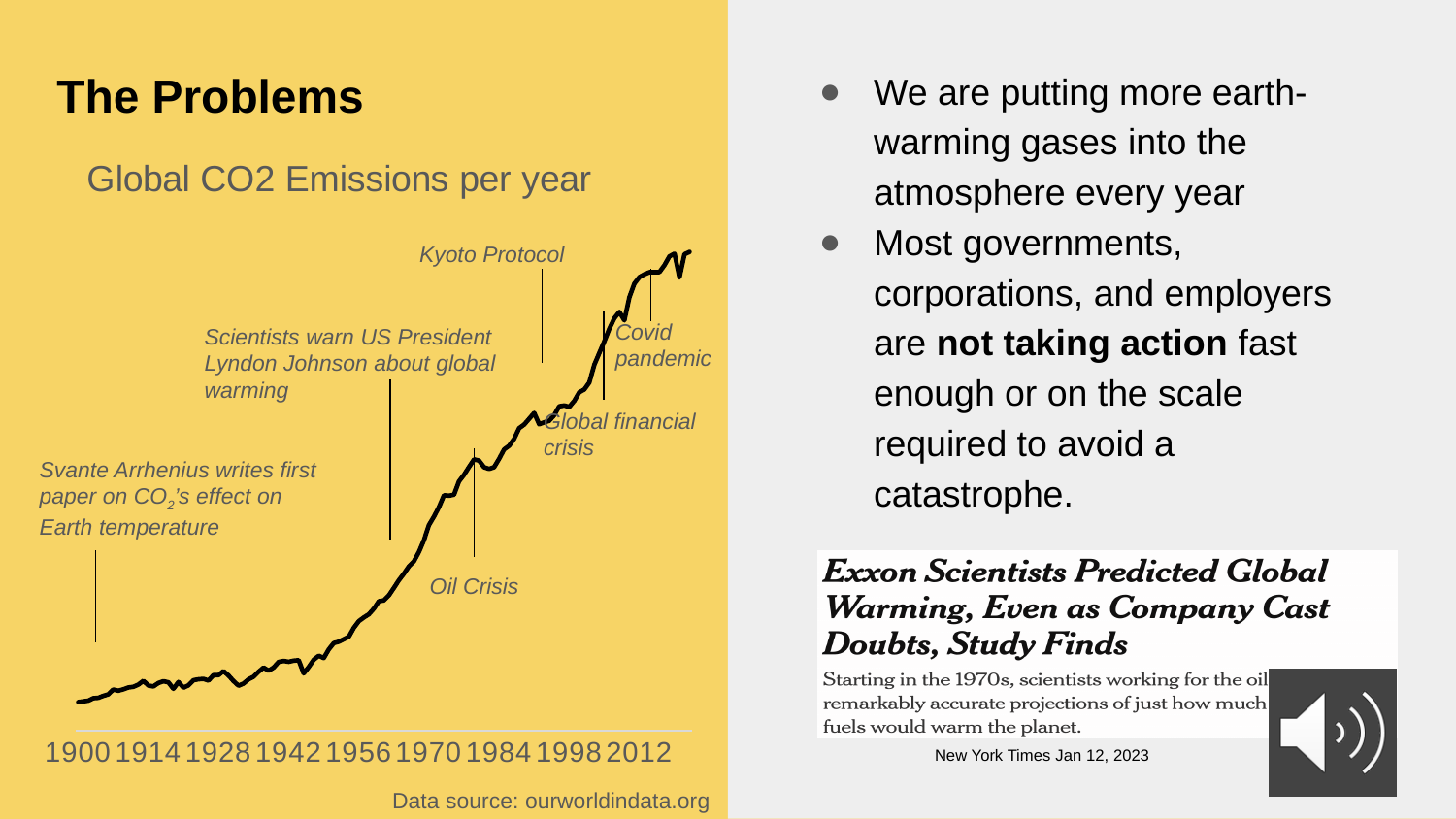
How many year labels are shown on the x axis of the chart? 9 Which is larger in the chart: global CO2 emissions around 1900 or around 2012? around 2012 Which event annotation on the chart is placed earliest in time? Svante Arrhenius writes first paper on CO2's effect on Earth temperature What kind of chart is shown on the slide? line chart Which event annotation on the chart is placed latest in time? Covid pandemic What is the last year labelled on the x axis of the chart? 2012 What data source is cited for the chart? ourworldindata.org Is the chart's line higher at the Kyoto Protocol annotation or at the Oil Crisis annotation? Kyoto Protocol Do global CO2 emissions rise or fall overall from 1900 to 2012 in the chart? rise How many event annotations are marked on the chart? 6